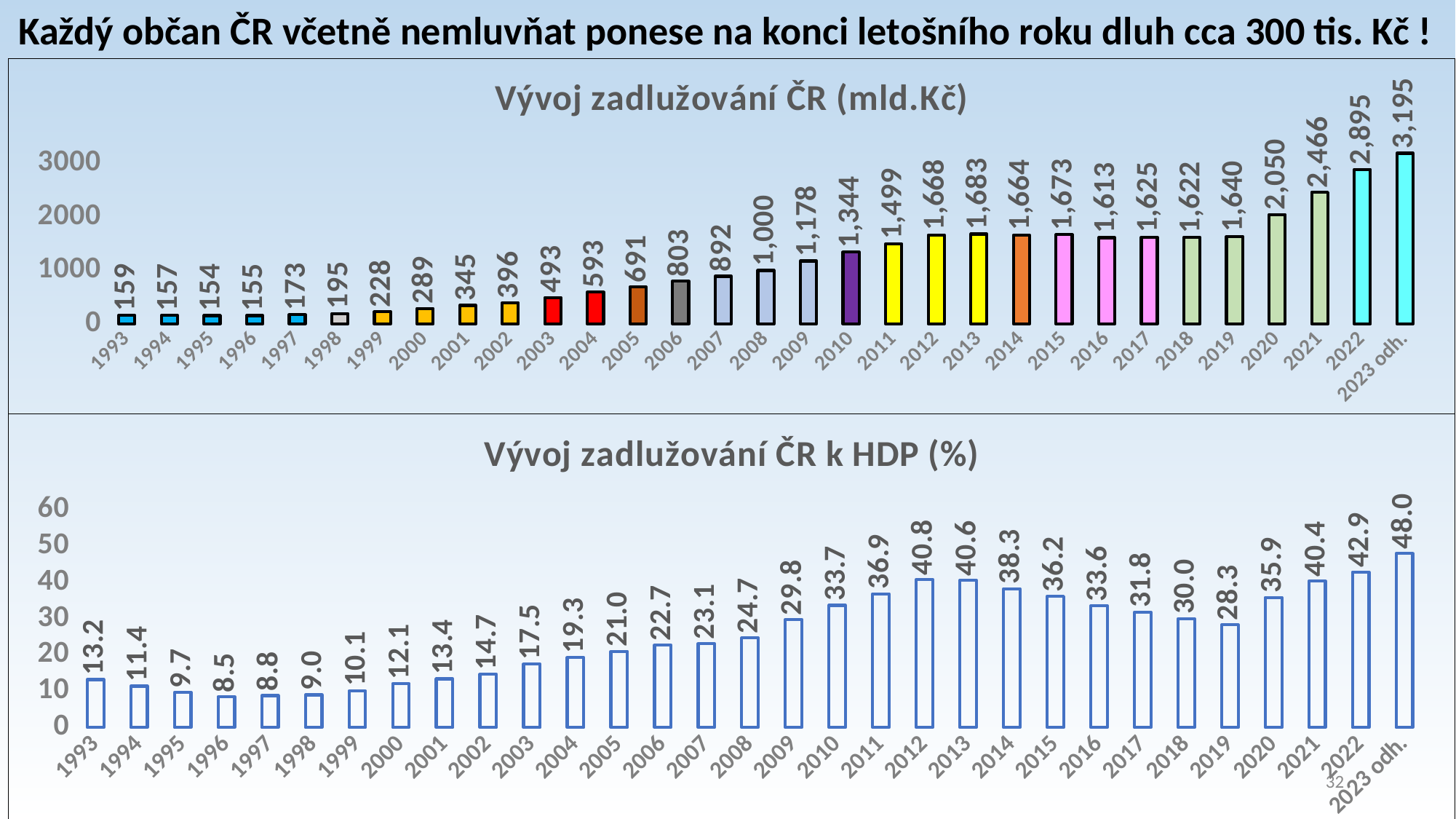
In the chart titled "Vývoj zadlužování ČR k HDP (%)", which year has the lowest value? 1996 In the chart titled "Vývoj zadlužování ČR (mld.Kč)", which year has the lowest value? 1995 In the chart titled "Vývoj zadlužování ČR (mld.Kč)", what is the value for 2010? 1,344 In the chart titled "Vývoj zadlužování ČR k HDP (%)", what is the difference between the values for 2023 odh. and 2022? 5.1 In the chart titled "Vývoj zadlužování ČR (mld.Kč)", which is larger, the value for 2013 or the value for 2014? 2013 In the chart titled "Vývoj zadlužování ČR (mld.Kč)", what is the value for 2023 odh.? 3,195 In the chart titled "Vývoj zadlužování ČR k HDP (%)", is the value for 2019 greater or less than 30? less In the chart titled "Vývoj zadlužování ČR (mld.Kč)", what is the difference between the values for 2022 and 2021? 429 In the chart titled "Vývoj zadlužování ČR k HDP (%)", what is the value for 2012? 40.8 What kind of chart is the chart titled "Vývoj zadlužování ČR k HDP (%)"? bar chart In the chart titled "Vývoj zadlužování ČR k HDP (%)", which year has the highest value? 2023 odh. In the chart titled "Vývoj zadlužování ČR (mld.Kč)", how many years are shown on the x axis? 31